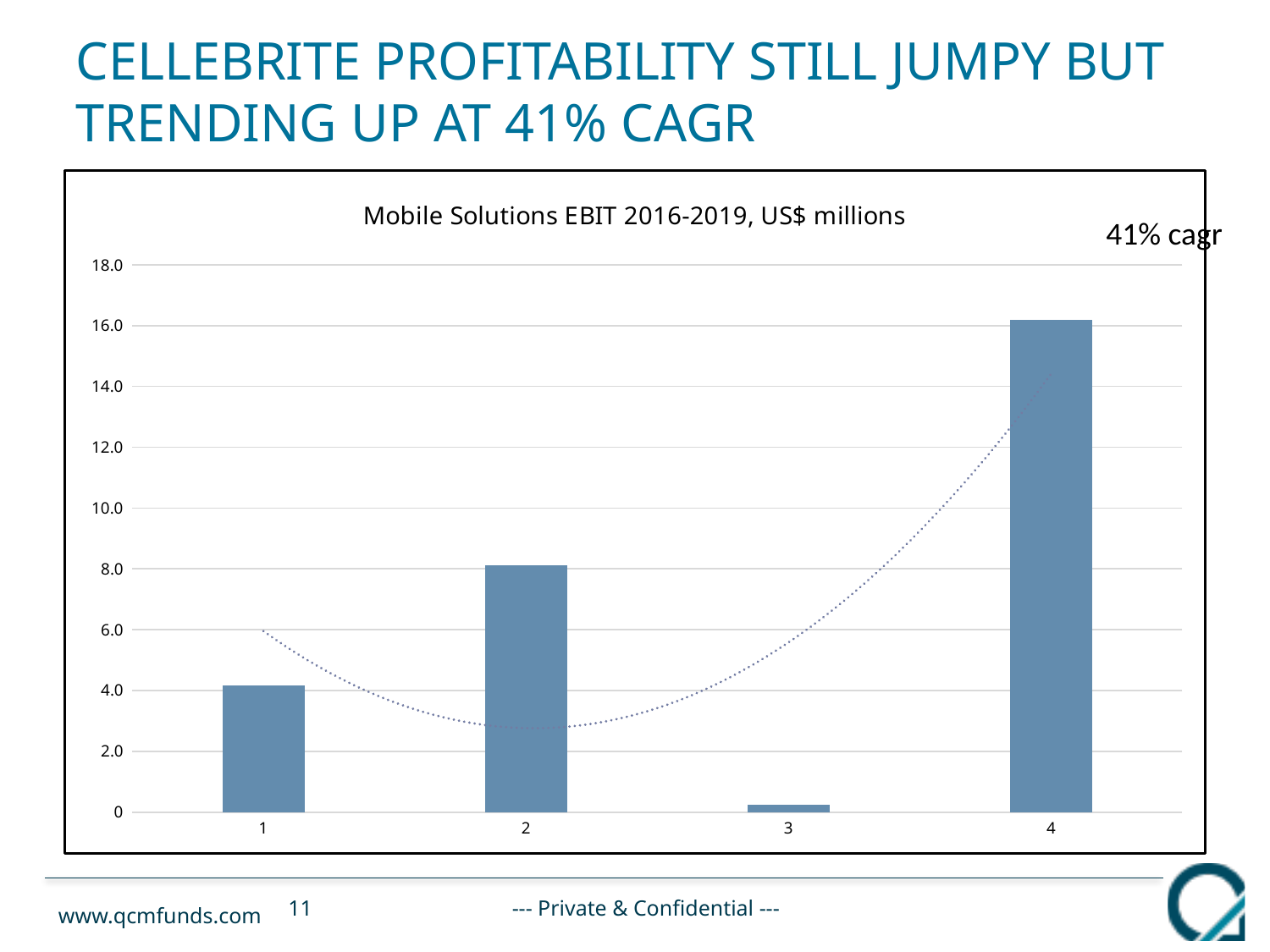
Is the value for category 3 greater or less than 2.0? less What CAGR is annotated on the chart? 41% cagr Is the value for category 2 greater or less than 6.0? greater Which category has the lowest bar? 3 Which is larger, the value for category 1 or the value for category 2? 2 What is the title of the chart? Mobile Solutions EBIT 2016-2019, US$ millions What kind of chart is shown on the slide? bar chart How many bars (categories) are plotted in the chart? 4 Is the value for category 1 greater or less than 6.0? less Which is larger, the value for category 2 or the value for category 4? 4 Which category has the highest bar? 4